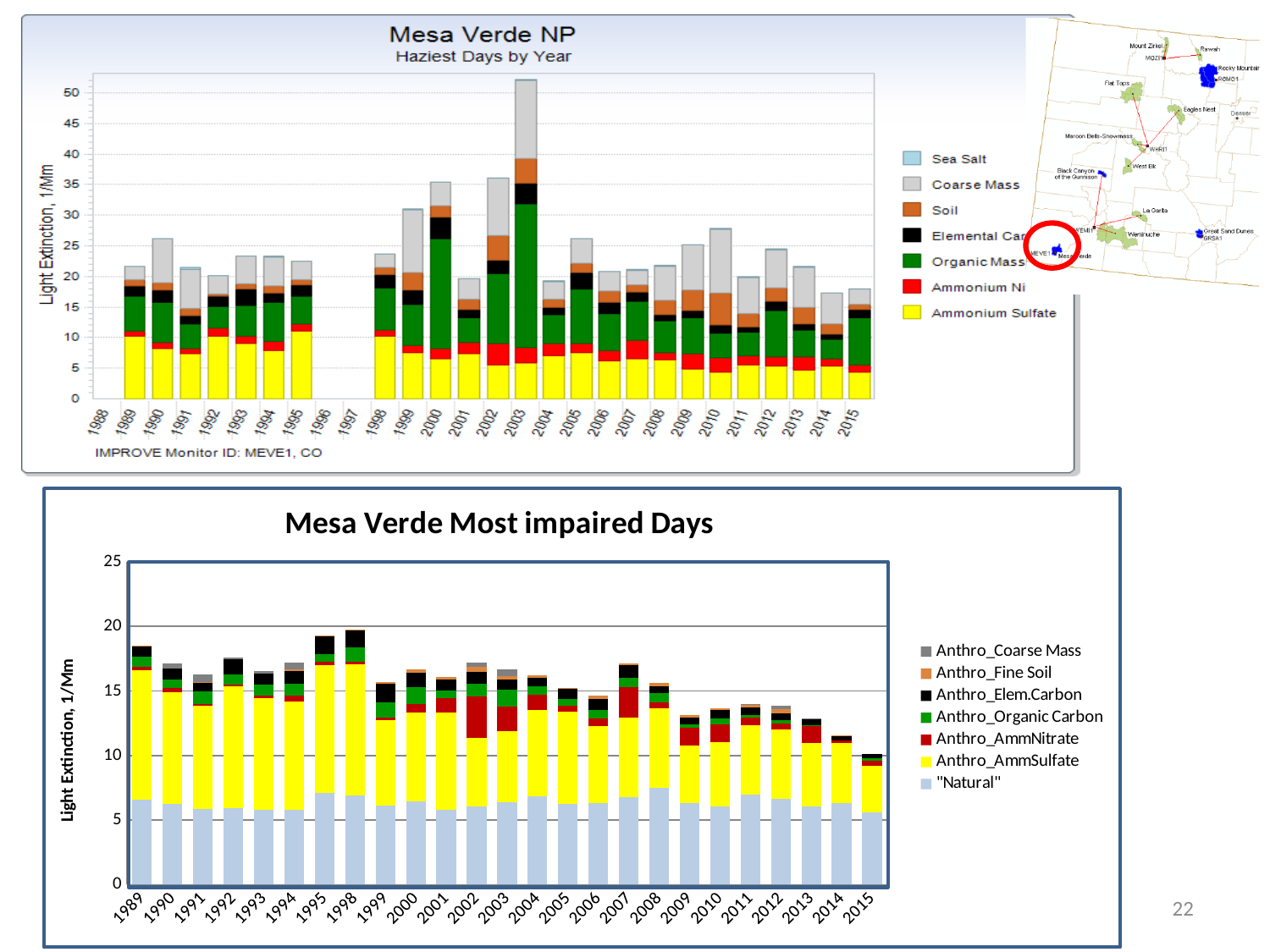
How many year bars are plotted in the "Mesa Verde Most impaired Days" chart? 25 What kind of chart is the "Mesa Verde Most impaired Days" chart? Stacked bar chart In the "Mesa Verde Most impaired Days" chart, is the total for 2015 greater or less than 15? less In the "Mesa Verde Most impaired Days" chart, which year has the shortest bar? 2015 In the "Mesa Verde Most impaired Days" chart, is the total for 1998 greater or less than 15? greater What is the y-axis label of the "Mesa Verde Most impaired Days" chart? Light Extinction, 1/Mm How many series does the legend of the "Mesa Verde Most impaired Days" chart list? 7 In the "Mesa Verde NP Haziest Days by Year" chart, is the total for 2014 greater or less than 20? less In the "Mesa Verde NP Haziest Days by Year" chart, which year has the tallest bar? 2003 How many series does the legend of the "Mesa Verde NP Haziest Days by Year" chart list? 7 In the "Mesa Verde Most impaired Days" chart, do the bar totals generally rise or fall from 1989 to 2015? fall